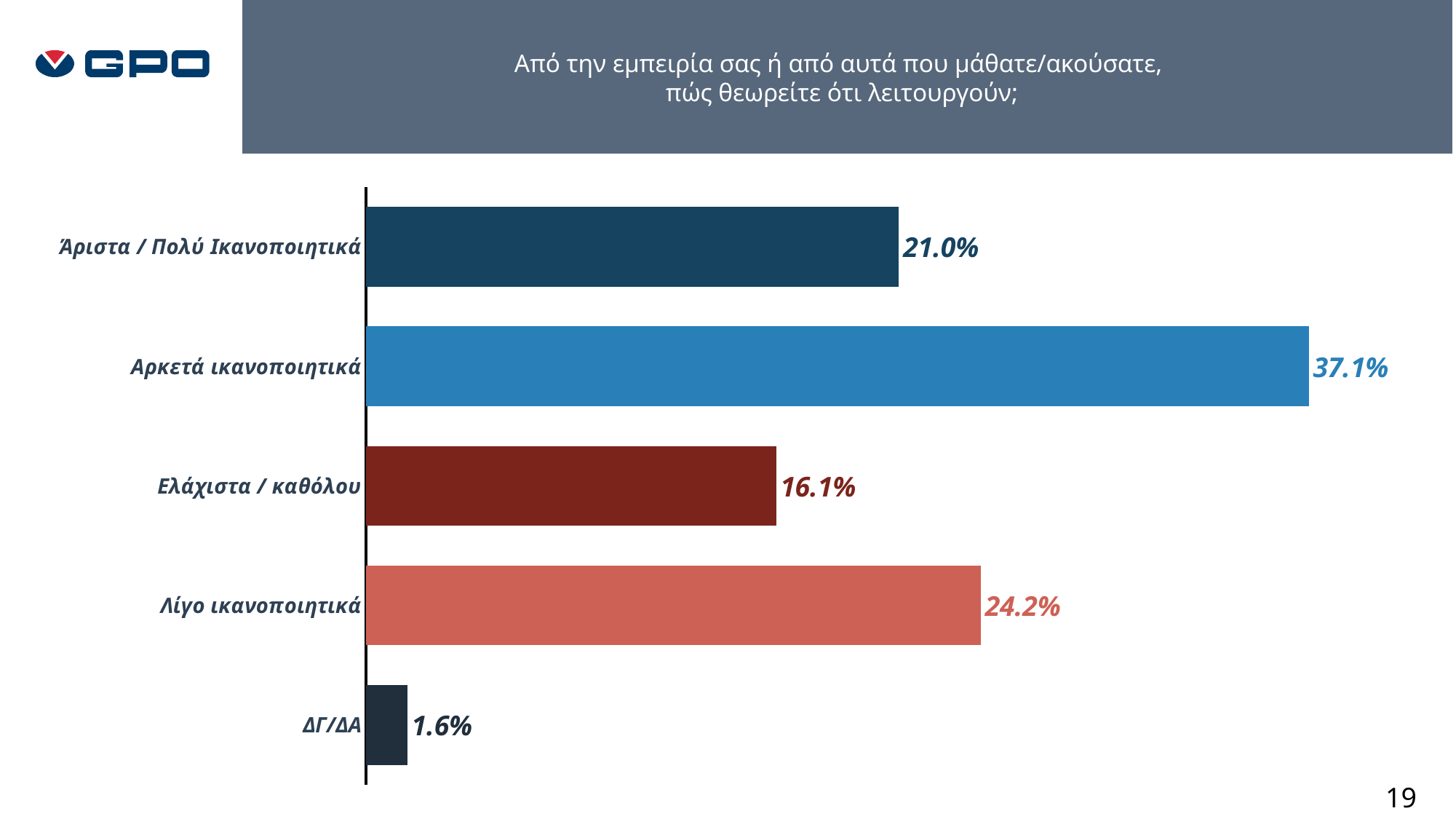
What is the value for Λίγο ικανοποιητικά? 24.2% Which category has the lowest value? ΔΓ/ΔΑ What colour is the bar for Ελάχιστα / καθόλου? Dark red What is the value for Αρκετά ικανοποιητικά? 37.1% What is the difference between the values for Αρκετά ικανοποιητικά and Λίγο ικανοποιητικά? 12.9% What is the value for Άριστα / Πολύ Ικανοποιητικά? 21.0% What is the value for ΔΓ/ΔΑ? 1.6% What kind of chart is shown on the slide? Bar chart Which is larger, the value for Άριστα / Πολύ Ικανοποιητικά or the value for Ελάχιστα / καθόλου? Άριστα / Πολύ Ικανοποιητικά What is the value for Ελάχιστα / καθόλου? 16.1% Which category has the highest value? Αρκετά ικανοποιητικά How many categories are shown in the chart? 5